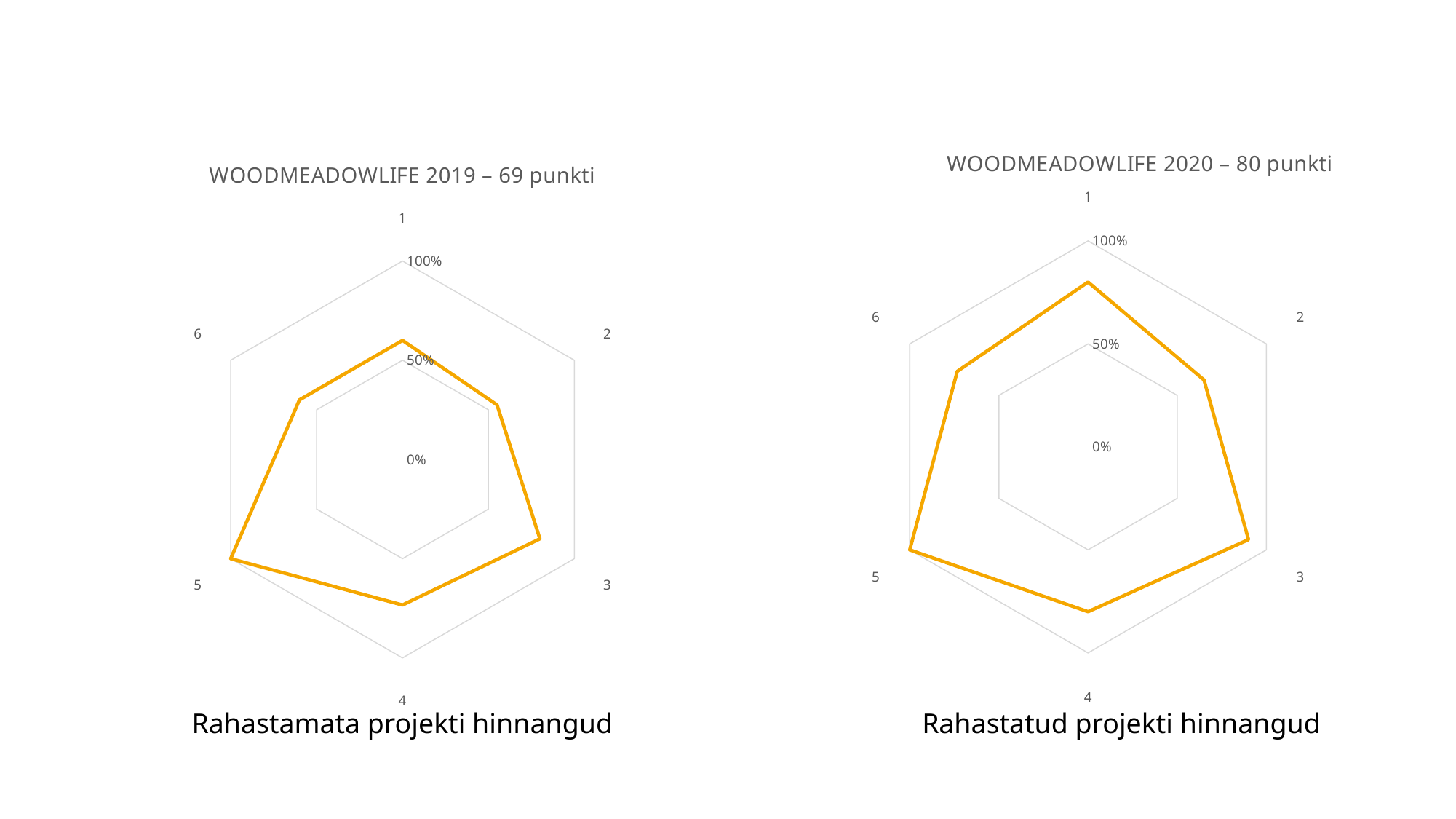
What caption appears below the left chart? Rahastamata projekti hinnangud In the left chart 'WOODMEADOWLIFE 2019 – 69 punkti', which is larger, the value for axis 5 or the value for axis 2? Axis 5 In the left chart 'WOODMEADOWLIFE 2019 – 69 punkti', is the value for axis 1 greater or less than 50%? greater In the right chart 'WOODMEADOWLIFE 2020 – 80 punkti', which is larger, the value for axis 3 or the value for axis 4? Axis 3 In the left chart 'WOODMEADOWLIFE 2019 – 69 punkti', which axis has the lowest value? 2 What kind of chart is the left chart titled 'WOODMEADOWLIFE 2019 – 69 punkti'? Radar chart What is the title of the right chart? WOODMEADOWLIFE 2020 – 80 punkti How many axes (categories) does the right chart 'WOODMEADOWLIFE 2020 – 80 punkti' have? 6 In the left chart 'WOODMEADOWLIFE 2019 – 69 punkti', which axis has the highest value? 5 In the right chart 'WOODMEADOWLIFE 2020 – 80 punkti', is the value for axis 1 greater or less than 100%? less In the right chart 'WOODMEADOWLIFE 2020 – 80 punkti', is the value for axis 4 greater or less than 50%? greater